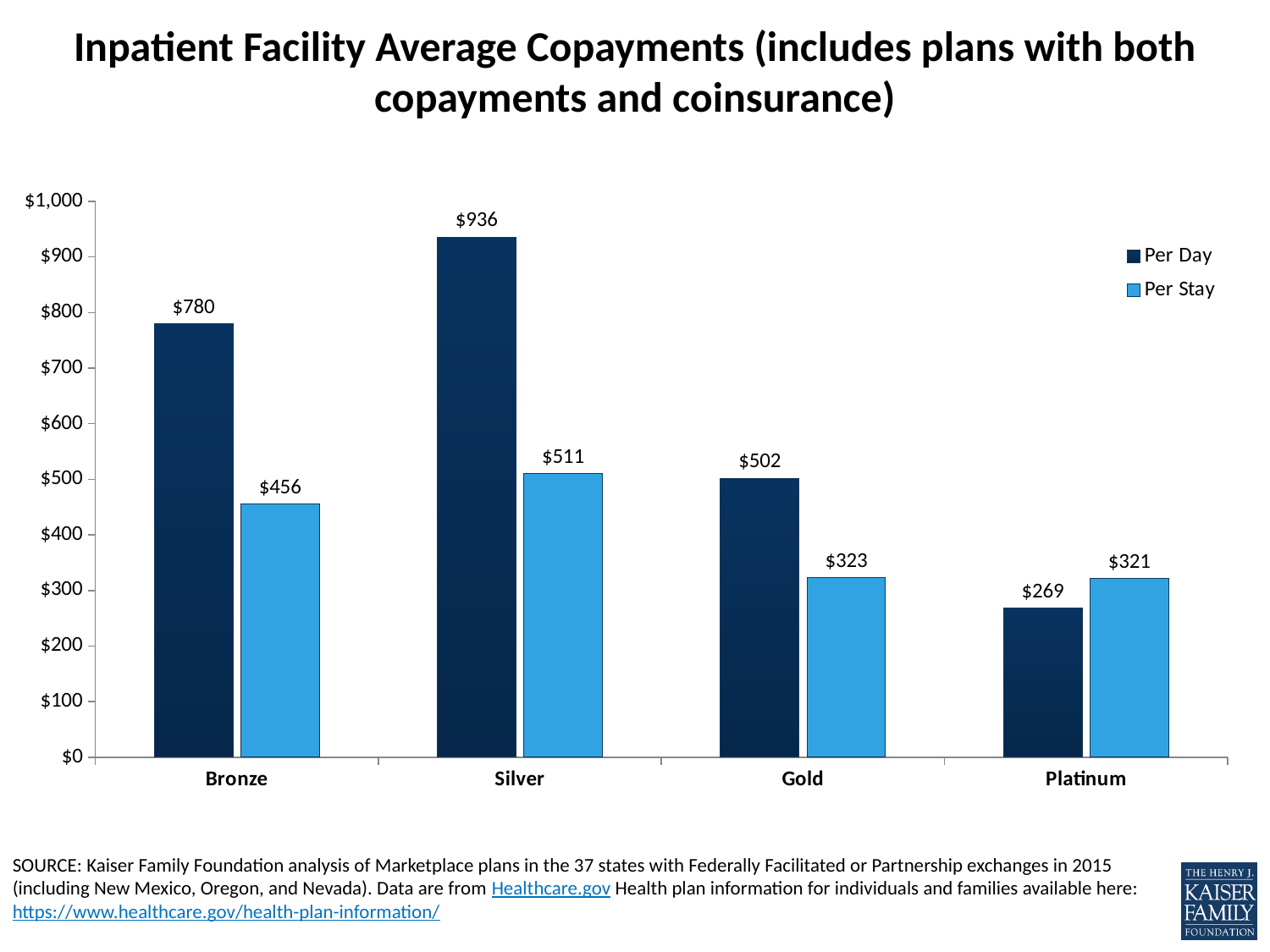
How many metal levels are shown on the x axis? 4 How many series does the legend list? 2 What is the Per Day average copayment for Platinum plans? $269 What is the Per Stay average copayment for Bronze plans? $456 Does the Per Day average copayment rise or fall from Silver to Platinum? Fall What is the difference between the Per Day and Per Stay average copayments for Gold plans? $179 Which is larger for Platinum plans, the Per Day or the Per Stay average copayment? Per Stay What kind of chart is shown on the slide? Bar chart Which metal level has the highest Per Day average copayment? Silver Which metal level has the lowest Per Stay average copayment? Platinum What are the two series listed in the legend? Per Day and Per Stay What is the Per Day average copayment for Silver plans? $936